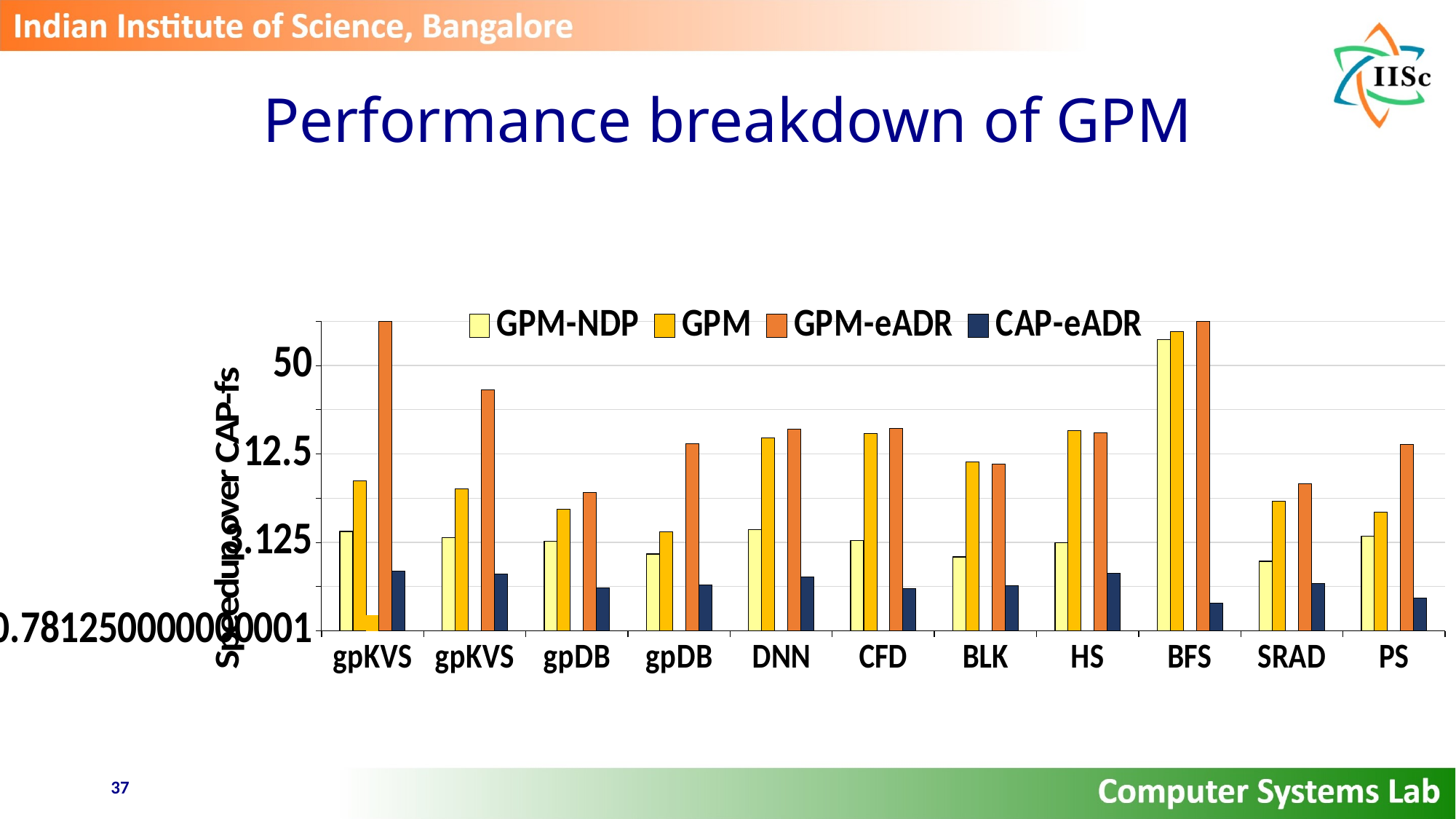
Is the CAP-eADR value for HS greater or less than 12.5? less What kind of chart is shown on the slide? bar chart Is the GPM-eADR value for the second gpKVS greater or less than 12.5? greater Which category has the highest GPM-NDP value? BFS Which category has the highest GPM value? BFS How many categories are shown along the x axis? 11 For PS, which is larger: GPM or GPM-eADR? GPM-eADR For DNN, which is larger: GPM-NDP or CAP-eADR? GPM-NDP What is the title of the y axis? Speedup over CAP-fs Is the GPM-eADR value for BFS greater or less than 50? greater How many series does the legend list? 4